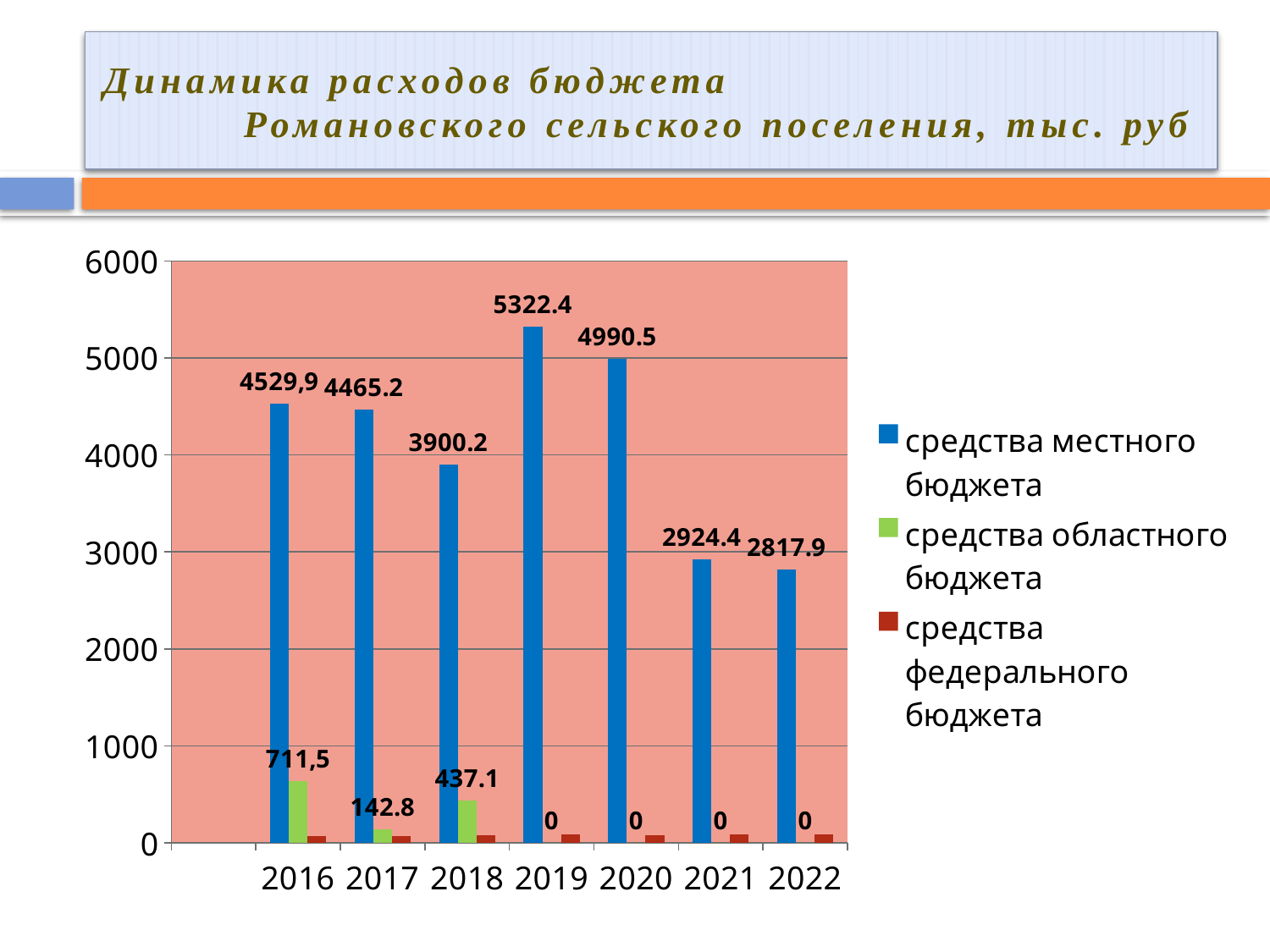
What type of chart is shown on the slide? bar chart What is the value of средства местного бюджета in 2019? 5322.4 Which is larger, средства местного бюджета in 2017 or in 2018? 2017 Is the value of средства местного бюджета in 2021 greater or less than 3000? less What is the value of средства областного бюджета in 2018? 437.1 What is the value of средства местного бюджета in 2022? 2817.9 In which year is средства местного бюджета the highest? 2019 What is the difference between средства местного бюджета in 2019 and in 2020? 331.9 Which colour represents средства федерального бюджета in the legend? red In which year is средства местного бюджета the lowest? 2022 How many years are shown on the x axis? 7 How many series does the legend list? 3